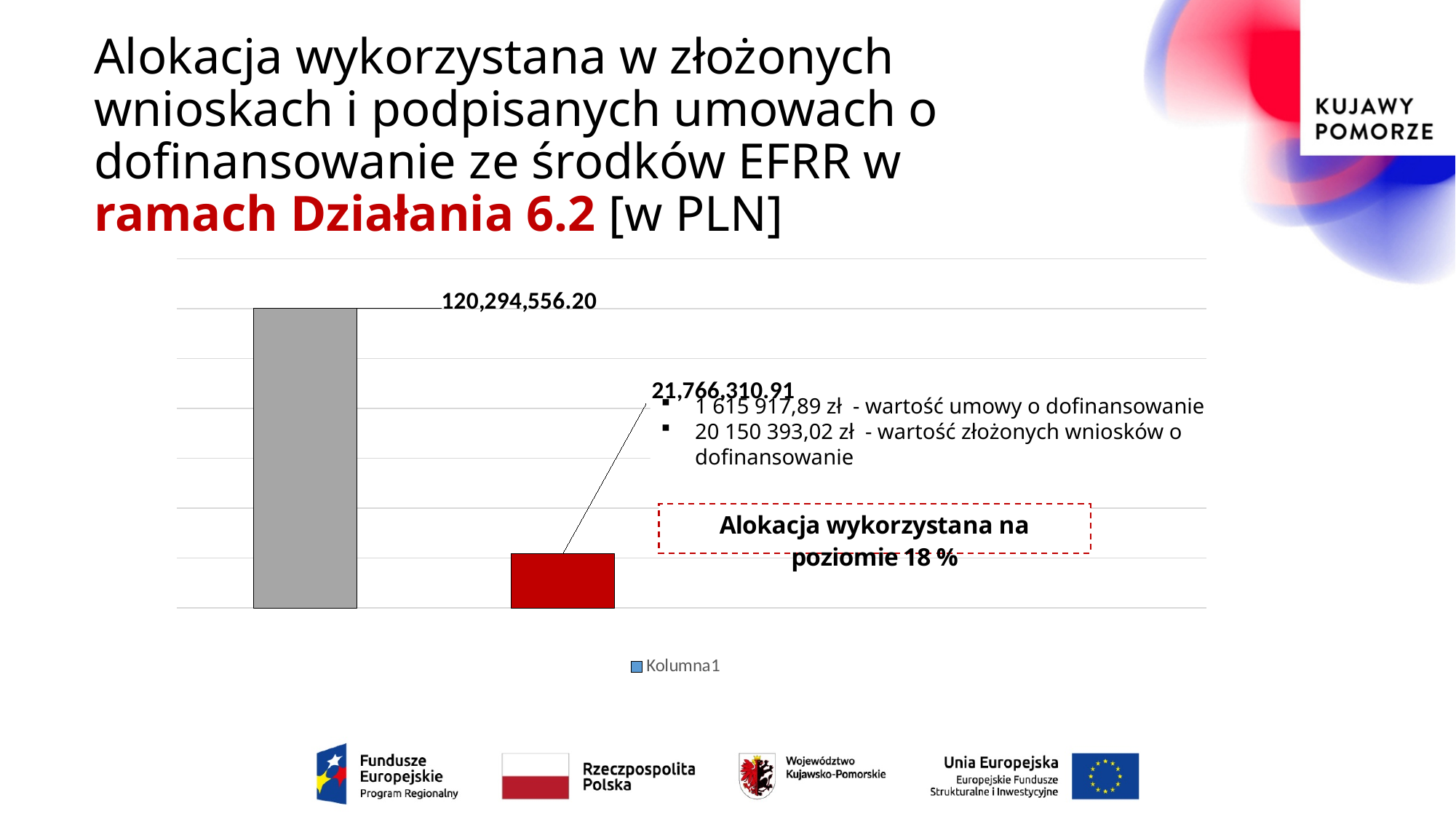
How many bars are plotted in the chart? 2 What kind of chart is shown on the slide? bar chart What is the name of the series shown in the chart legend? Kolumna1 How many series does the chart legend list? 1 What is the difference between the value of the gray bar and the value of the red bar? 98,528,245.29 Which bar has the lowest value, the gray one or the red one? the red bar Which bar has the highest value, the gray one or the red one? the gray bar What colour is the bar with the larger value? gray What value is labelled on the gray bar in the chart? 120,294,556.20 Is the value of the red bar larger or smaller than the value of the gray bar? smaller What value is labelled on the red bar in the chart? 21,766,310.91